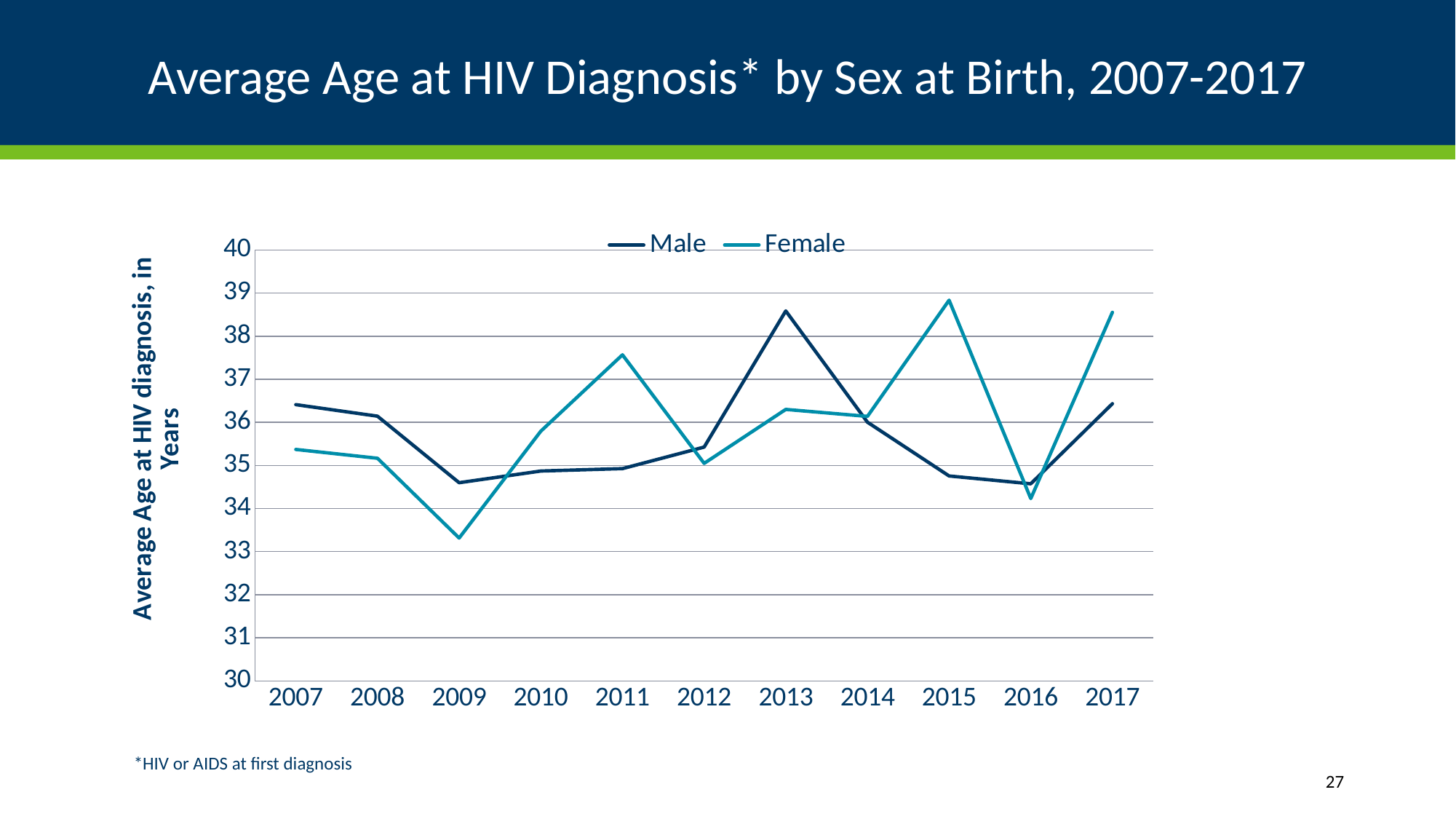
What is the title of the y axis? Average Age at HIV diagnosis, in Years Is the Male value for 2013 greater or less than 38? greater How many years are plotted along the x axis? 11 In 2013, which series has the higher average age, Male or Female? Male In which year is the Female average age at HIV diagnosis lowest? 2009 Is the Female value for 2009 greater or less than 34? less What kind of chart is shown on the slide? line chart Is the Male value for 2009 greater or less than 35? less How many series does the legend list? 2 In 2015, which series has the higher average age, Male or Female? Female In which year is the Male average age at HIV diagnosis highest? 2013